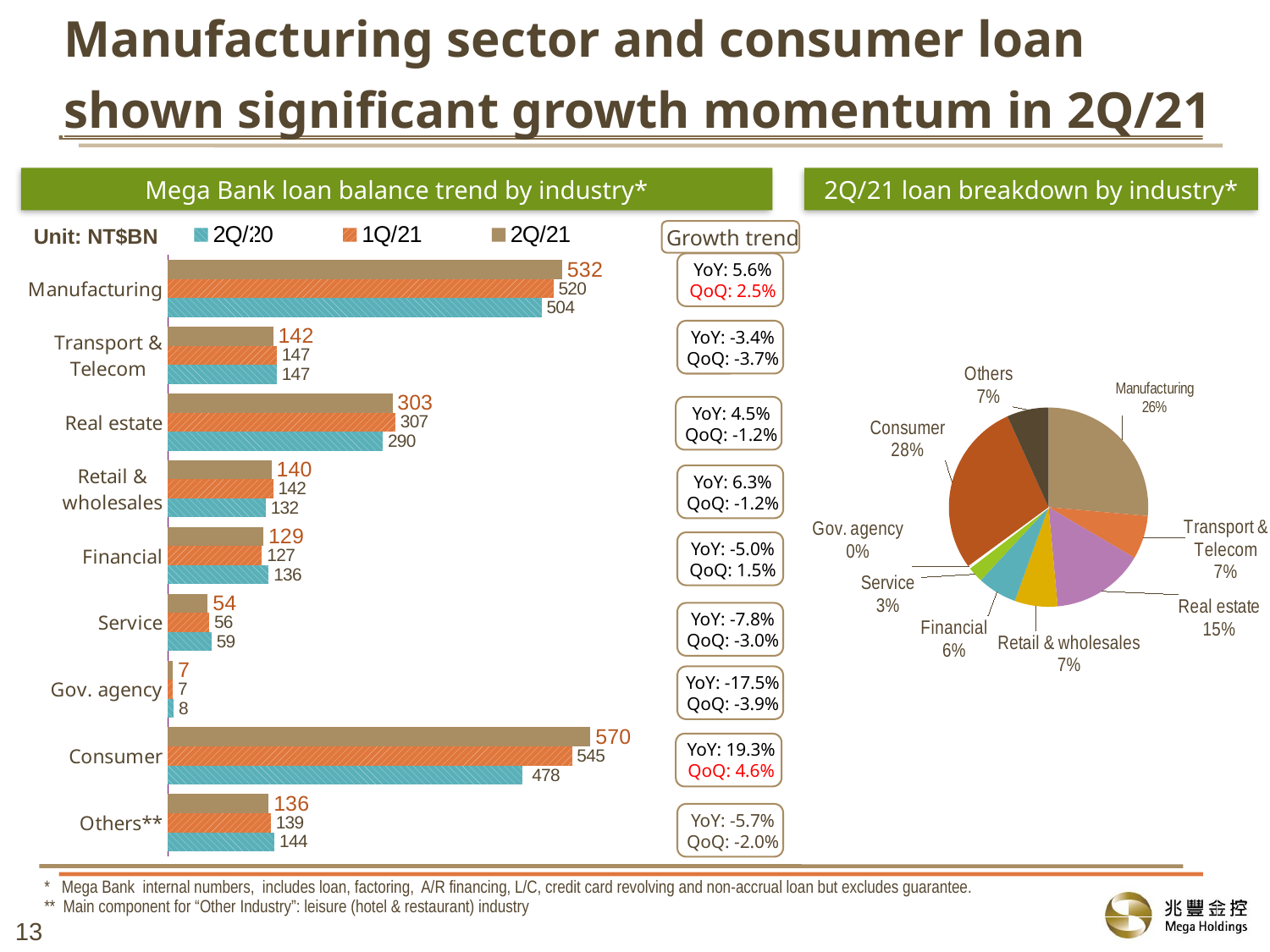
In the 'Mega Bank loan balance trend by industry' chart, which industry has the highest 2Q/21 loan balance? Consumer In the 'Mega Bank loan balance trend by industry' chart, which is larger for Real estate: the 1Q/21 value or the 2Q/21 value? 1Q/21 In the 'Mega Bank loan balance trend by industry' chart, what is the 2Q/21 loan balance for Manufacturing? 532 In the 'Mega Bank loan balance trend by industry' chart, what is the difference between the 2Q/21 and 2Q/20 values for Consumer? 92 In the '2Q/21 loan breakdown by industry' pie chart, what share does Consumer have? 28% What unit is stated for the 'Mega Bank loan balance trend by industry' chart? NT$BN In the 'Mega Bank loan balance trend by industry' chart, what is the 2Q/20 value for Consumer? 478 In the '2Q/21 loan breakdown by industry' pie chart, what share does Real estate have? 15% In the 'Mega Bank loan balance trend by industry' chart, which industry has the lowest 2Q/21 loan balance? Gov. agency How many industry categories are shown in the 'Mega Bank loan balance trend by industry' chart? 9 How many series does the legend of the 'Mega Bank loan balance trend by industry' chart list? 3 What type of chart is the 'Mega Bank loan balance trend by industry' chart? Bar chart